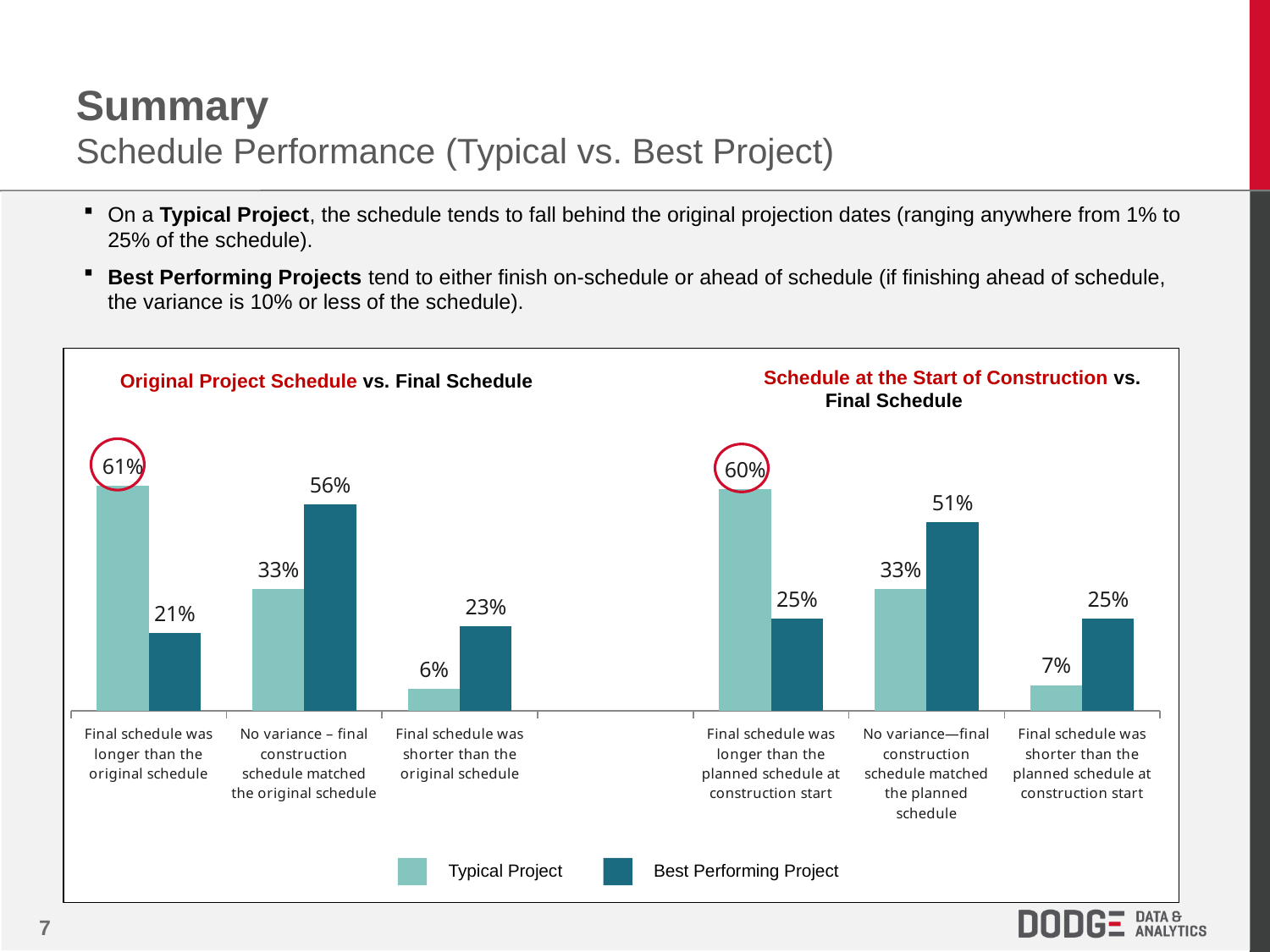
In the 'Schedule at the Start of Construction vs. Final Schedule' chart, what is the difference between the Best Performing Project and Typical Project values for 'Final schedule was shorter than the planned schedule at construction start'? 18% In the 'Original Project Schedule vs. Final Schedule' chart, what is the difference between the Typical Project and Best Performing Project values for 'Final schedule was longer than the original schedule'? 40% In the 'Original Project Schedule vs. Final Schedule' chart, which category has the lowest Typical Project value? Final schedule was shorter than the original schedule How many series does the legend list for the charts on the slide? 2 In the 'Original Project Schedule vs. Final Schedule' chart, which is larger for 'No variance – final construction schedule matched the original schedule': the Typical Project value or the Best Performing Project value? Best Performing Project In the 'Schedule at the Start of Construction vs. Final Schedule' chart, what is the Typical Project value for 'Final schedule was shorter than the planned schedule at construction start'? 7% In the 'Schedule at the Start of Construction vs. Final Schedule' chart, which category has the highest Best Performing Project value? No variance—final construction schedule matched the planned schedule How many categories are shown on the x axis of the 'Schedule at the Start of Construction vs. Final Schedule' chart? 3 What kind of chart is the 'Original Project Schedule vs. Final Schedule' chart? Bar chart In the 'Schedule at the Start of Construction vs. Final Schedule' chart, what is the Best Performing Project value for 'No variance—final construction schedule matched the planned schedule'? 51% In the 'Original Project Schedule vs. Final Schedule' chart, what is the Typical Project value for 'Final schedule was longer than the original schedule'? 61% In the 'Original Project Schedule vs. Final Schedule' chart, what is the Best Performing Project value for 'No variance – final construction schedule matched the original schedule'? 56%